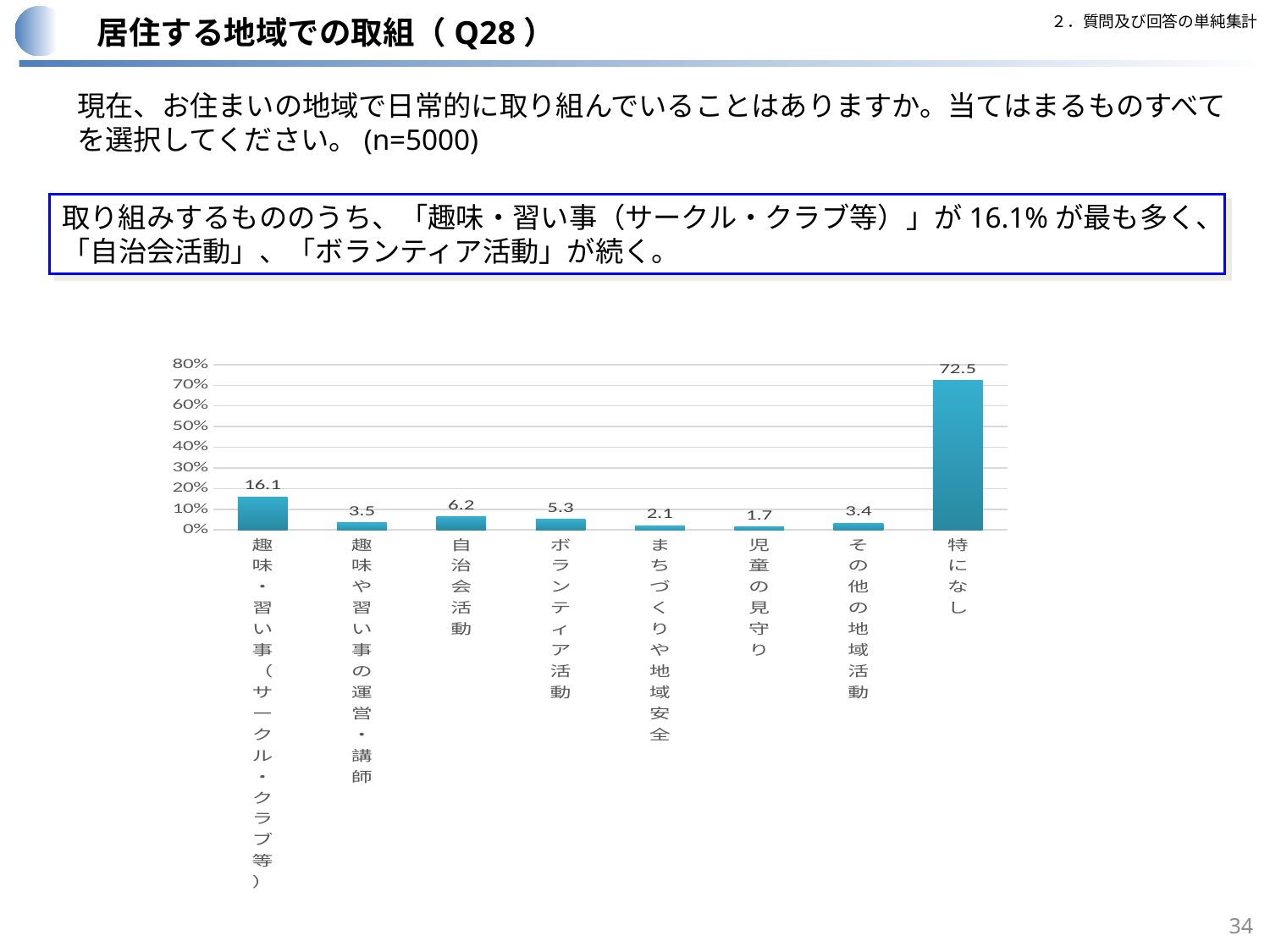
What is the highest value shown on the vertical axis? 80% What is the difference between the values for 自治会活動 and ボランティア活動? 0.9 Is the value for 特になし greater or less than 70%? greater How many categories are shown in the chart? 8 What is the value for 趣味・習い事（サークル・クラブ等）? 16.1 Which category has the lowest value? 児童の見守り Which category has the highest value? 特になし What is the value for 自治会活動? 6.2 What is the value for 特になし? 72.5 What kind of chart is shown on the slide? bar chart What is the value for 児童の見守り? 1.7 Which is larger, the value for 趣味や習い事の運営・講師 or the value for その他の地域活動? 趣味や習い事の運営・講師